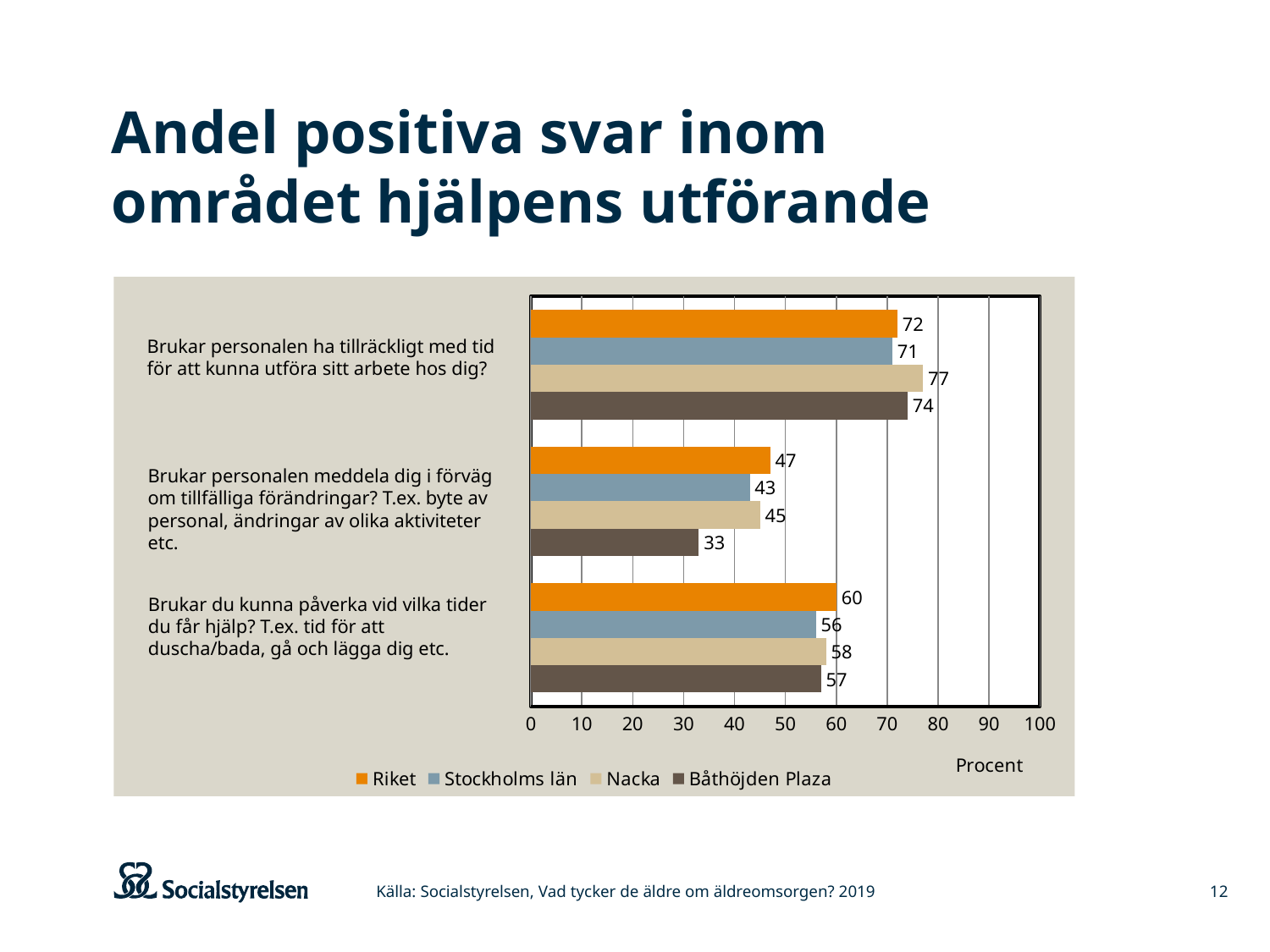
How many series does the legend list? 4 What is the value for Nacka on the question "Brukar personalen ha tillräckligt med tid för att kunna utföra sitt arbete hos dig?" 77 How many questions (categories) are shown on the chart? 3 What is the value for Båthöjden Plaza on the question about being informed in advance of temporary changes ("Brukar personalen meddela dig i förväg om tillfälliga förändringar?")? 33 Which series has the highest value on the question "Brukar personalen ha tillräckligt med tid för att kunna utföra sitt arbete hos dig?" Nacka What is the difference between Nacka and Stockholms län on the question "Brukar personalen ha tillräckligt med tid för att kunna utföra sitt arbete hos dig?" 6 Which series has the lowest value on the question about being informed in advance of temporary changes? Båthöjden Plaza Which is larger on the question "Brukar du kunna påverka vid vilka tider du får hjälp?": Stockholms län or Nacka? Nacka What is the label on the horizontal axis of the chart? Procent What kind of chart is shown on the slide? Bar chart What is the value for Riket on the question "Brukar du kunna påverka vid vilka tider du får hjälp?" 60 What is the difference between Riket and Båthöjden Plaza on the question about being informed in advance of temporary changes? 14